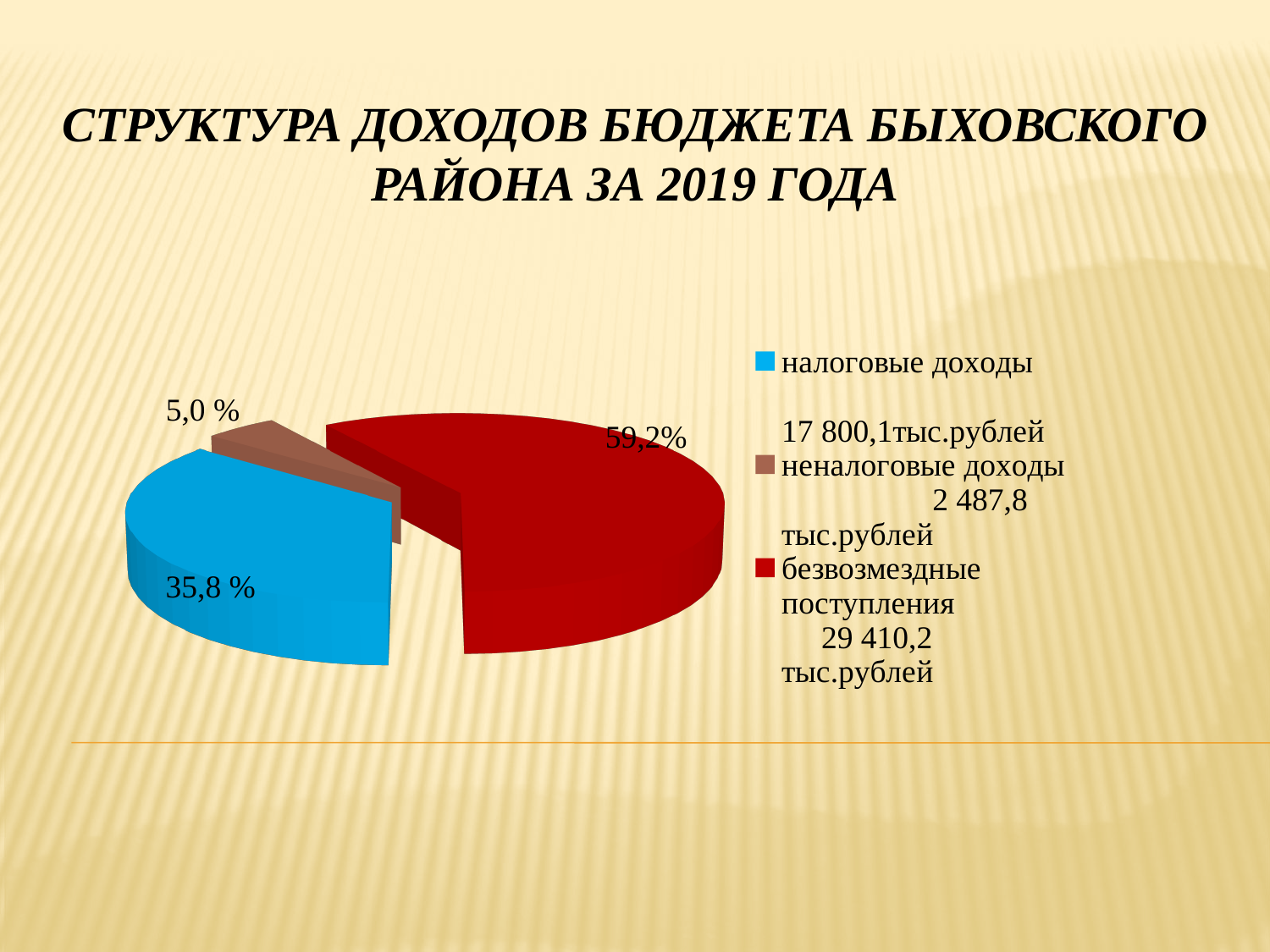
Which category has the smallest slice of the pie? неналоговые доходы What share of the pie is labelled for налоговые доходы? 35,8 % What amount in тыс.рублей does the legend give for безвозмездные поступления? 29 410,2 тыс.рублей What colour is the slice for неналоговые доходы? brown What share of the pie is labelled for безвозмездные поступления? 59,2% What is the difference in percentage points between the безвозмездные поступления slice and the налоговые доходы slice? 23,4 Which category has the largest slice of the pie? безвозмездные поступления What share of the pie is labelled for неналоговые доходы? 5,0 % How many slices does the pie chart have? 3 What amount in тыс.рублей does the legend give for налоговые доходы? 17 800,1 тыс.рублей Which is larger: the slice for налоговые доходы or the slice for безвозмездные поступления? безвозмездные поступления What kind of chart is shown on the slide? pie chart